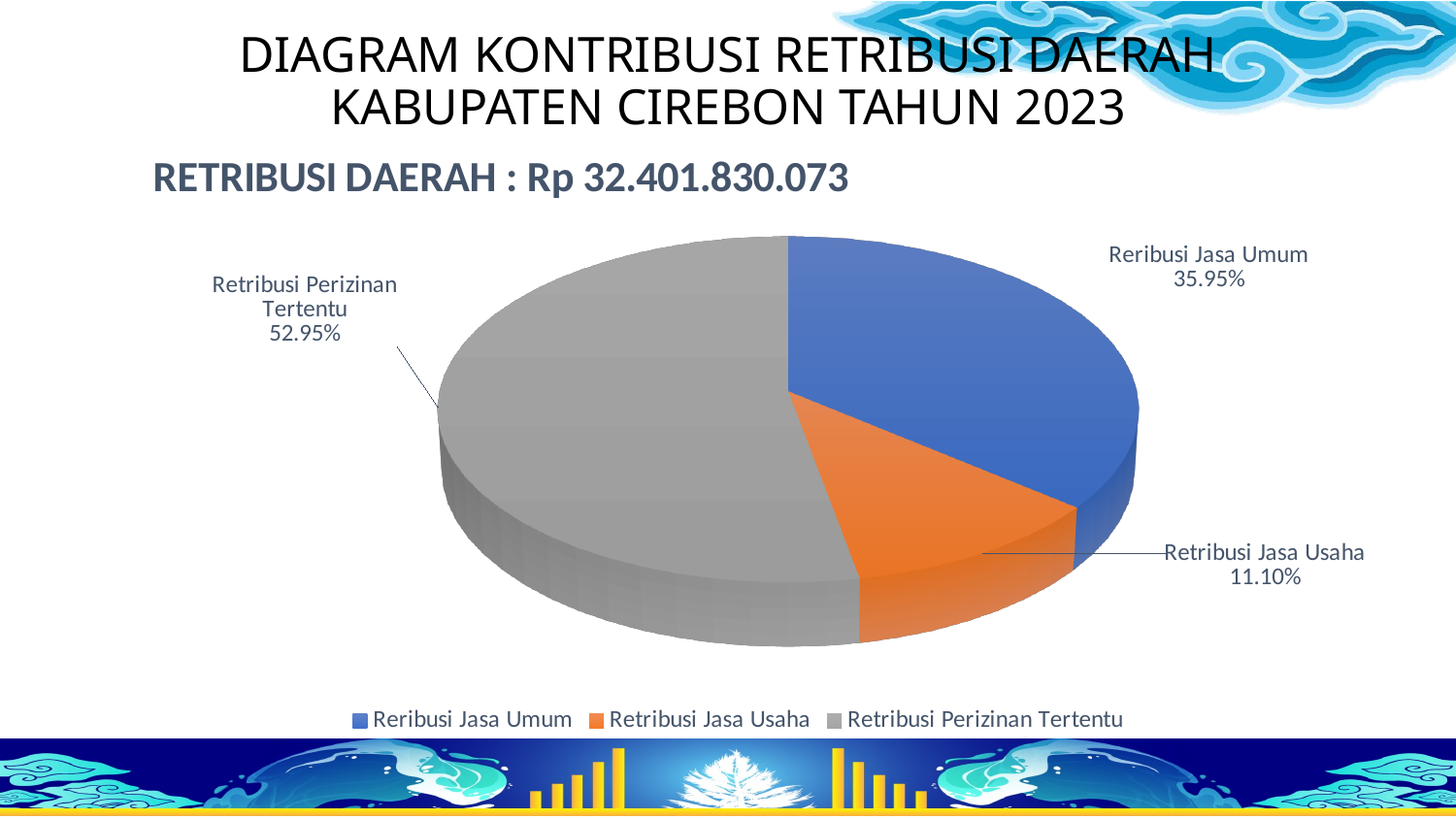
What kind of chart is shown on the slide? Pie chart What is the difference in percentage points between Retribusi Perizinan Tertentu and Reribusi Jasa Umum? 17.00 percentage points How many slices does the pie chart have? 3 Which is larger, the share for Reribusi Jasa Umum or the share for Retribusi Jasa Usaha? Reribusi Jasa Umum What share of the pie does Reribusi Jasa Umum have? 35.95% Which category has the largest slice of the pie? Retribusi Perizinan Tertentu Which colour represents Retribusi Jasa Usaha in the pie chart? Orange How many entries does the legend list? 3 What share of the pie does Retribusi Jasa Usaha have? 11.10% Which category has the smallest slice of the pie? Retribusi Jasa Usaha What total value of Retribusi Daerah is stated on the slide? Rp 32.401.830.073 What share of the pie does Retribusi Perizinan Tertentu have? 52.95%